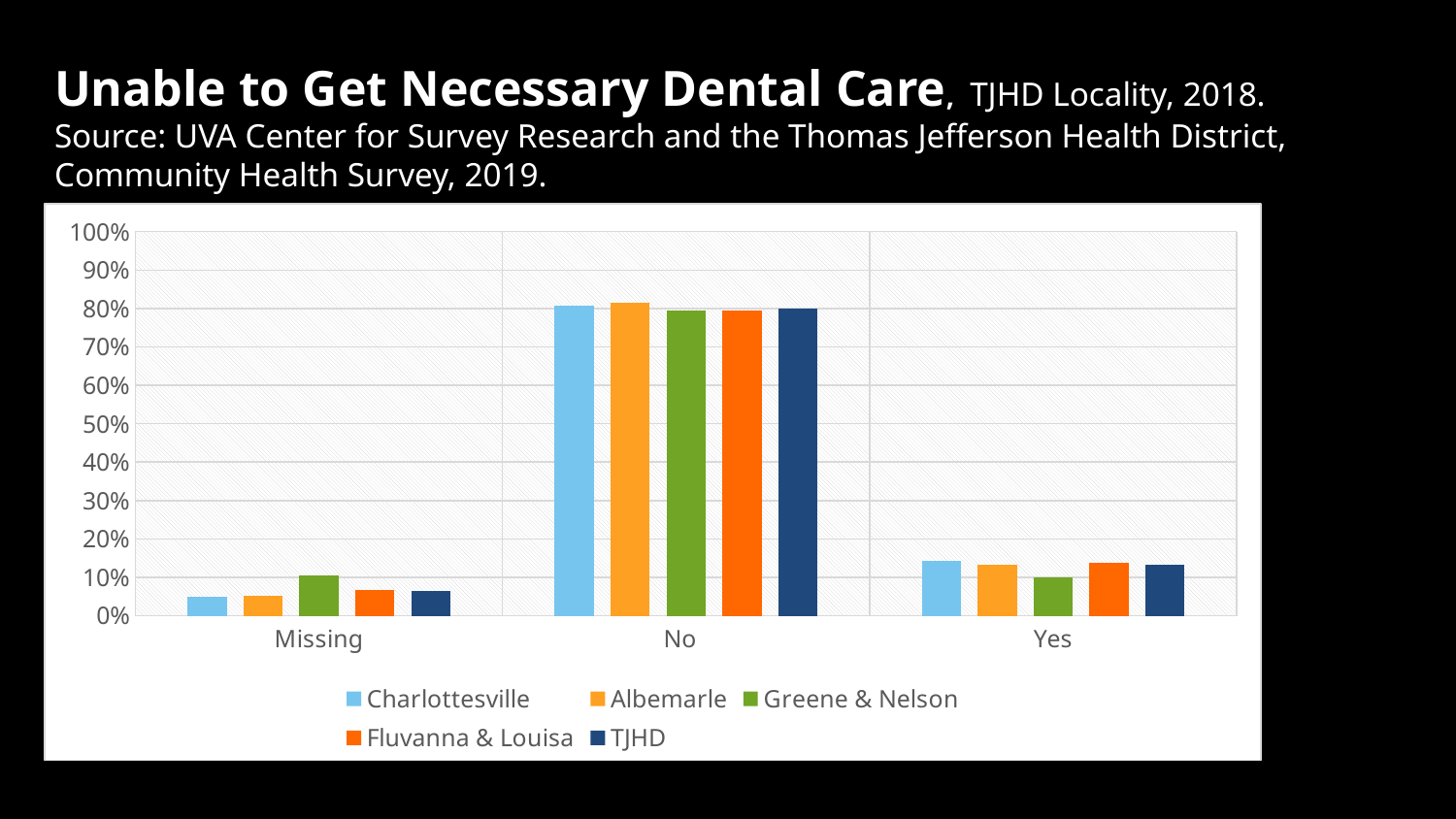
Is the value for Charlottesville in the Missing category greater or less than 10%? less Which series has the lowest value in the Yes category? Greene & Nelson How many series does the legend list? 5 In the Yes category, which is larger: Charlottesville or Greene & Nelson? Charlottesville Is the value for TJHD in the No category greater or less than 70%? greater Is the value for Charlottesville in the No category greater or less than 50%? greater In the Missing category, which is larger: Greene & Nelson or Charlottesville? Greene & Nelson What colour represents TJHD in the legend? dark blue How many categories are shown on the x axis? 3 Which category has the highest values across all series? No What kind of chart is shown on the slide? bar chart